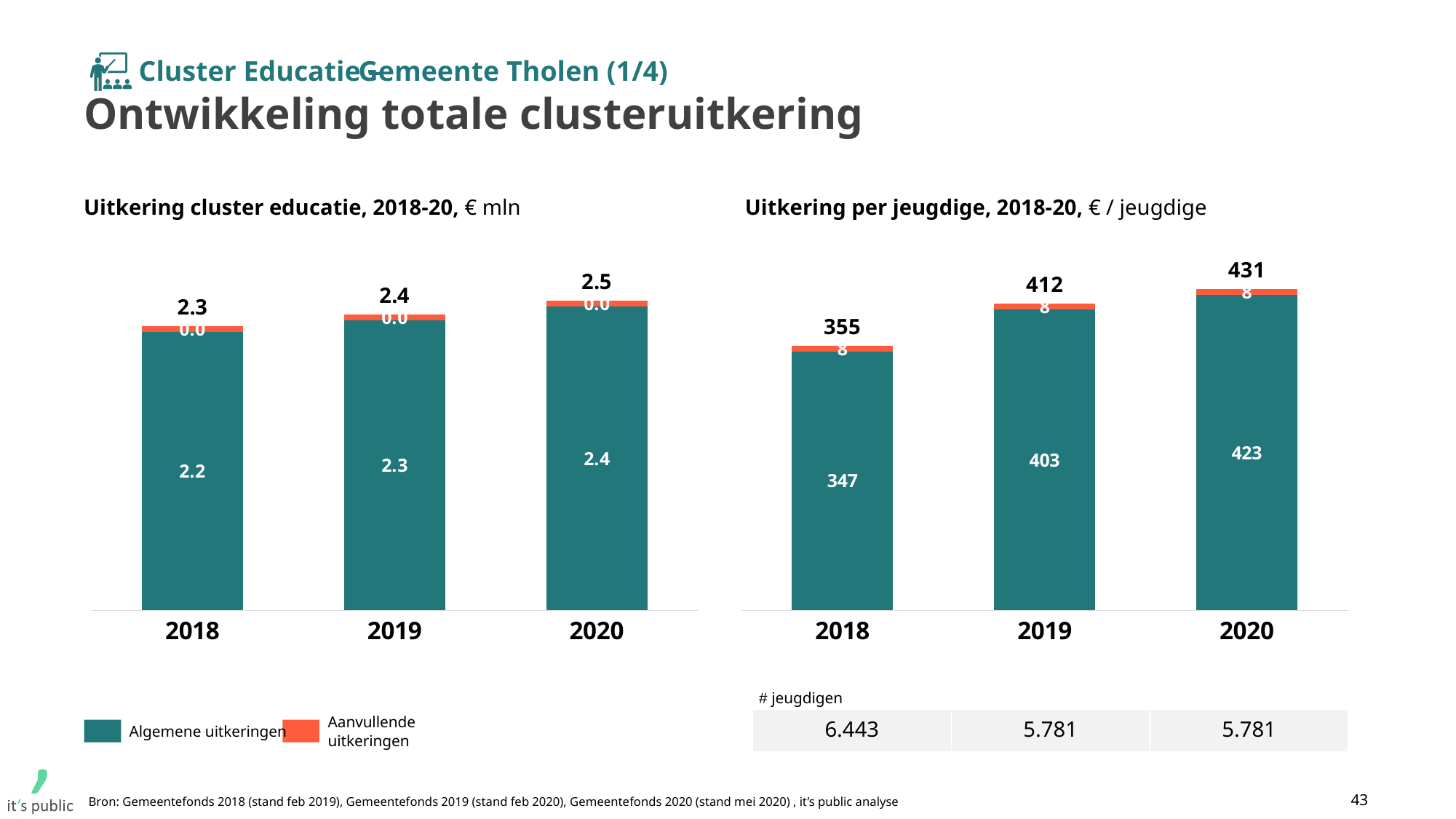
How many series does the legend list for the chart 'Uitkering cluster educatie, 2018-20'? 2 In the chart 'Uitkering per jeugdige, 2018-20', what is the difference between the total values for 2020 and 2018? 76 In the chart 'Uitkering cluster educatie, 2018-20', what is the value of Algemene uitkeringen for 2018? 2.2 In the chart 'Uitkering per jeugdige, 2018-20', what is the total value shown above the bar for 2019? 412 In the chart 'Uitkering per jeugdige, 2018-20', is the Algemene uitkeringen value larger for 2019 or for 2018? 2019 In the chart 'Uitkering cluster educatie, 2018-20', what is the total value shown above the bar for 2020? 2.5 In the chart 'Uitkering per jeugdige, 2018-20', what is the value of Aanvullende uitkeringen for 2018? 8 In the chart 'Uitkering cluster educatie, 2018-20', which year has the lowest total value? 2018 In the chart 'Uitkering per jeugdige, 2018-20', what is the value of Algemene uitkeringen for 2020? 423 In the chart 'Uitkering per jeugdige, 2018-20', which year has the highest total value? 2020 How many years are shown on the x axis of the chart 'Uitkering cluster educatie, 2018-20'? 3 Do the total values in the chart 'Uitkering per jeugdige, 2018-20' rise or fall from 2018 to 2020? rise